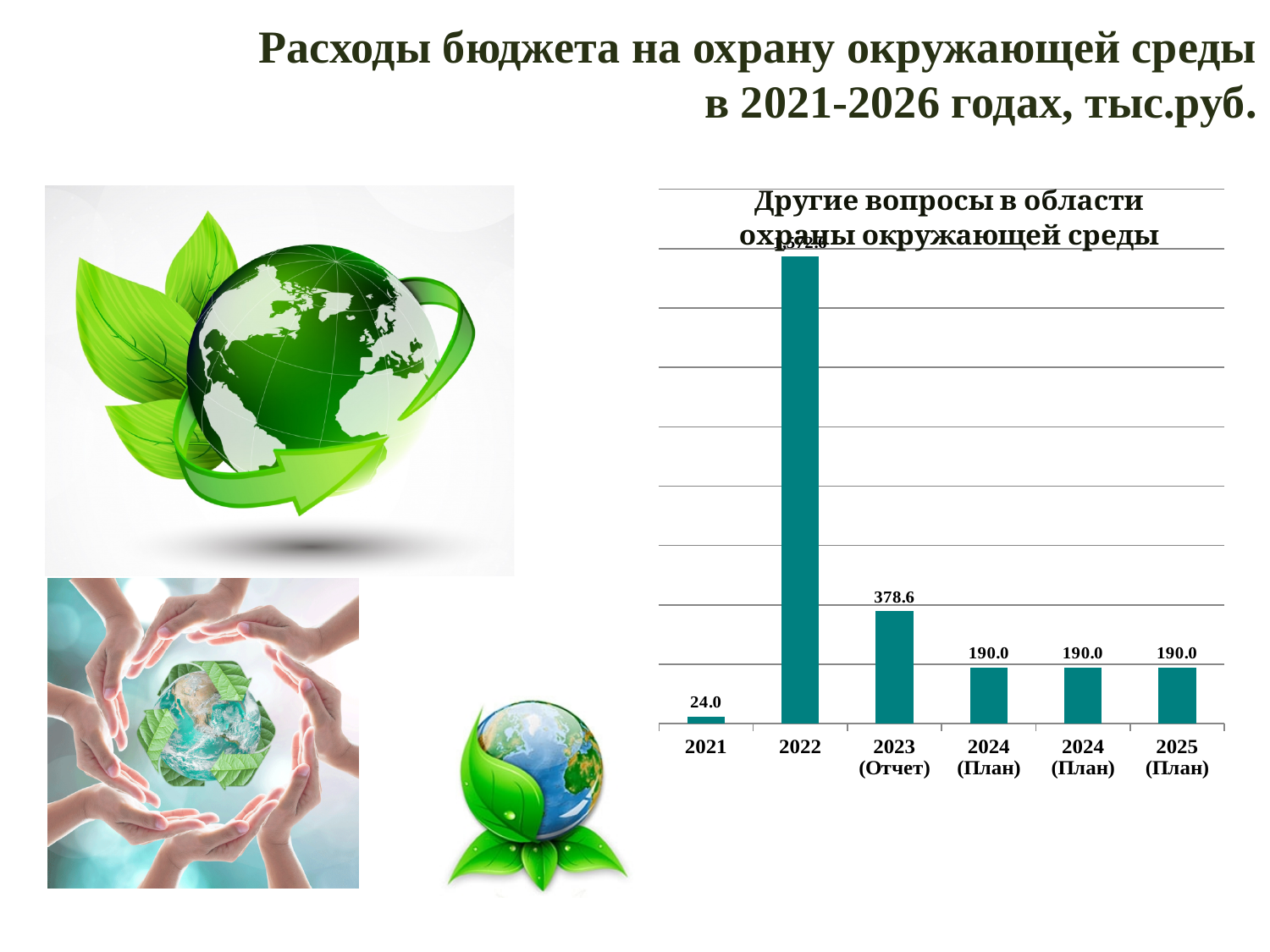
What is the title of the chart? Другие вопросы в области охраны окружающей среды What is the difference between the values for 2023 (Отчет) and 2025 (План)? 188.6 How many bars are shown in the chart? 6 What is the value for 2025 (План)? 190.0 Which year has the highest value? 2022 Do the values rise or fall from 2022 to 2023 (Отчет)? fall Which year has the lowest value? 2021 What type of chart is shown on the slide? bar chart What is the value for 2021? 24.0 Which is larger, the value for 2021 or the value for 2025 (План)? 2025 (План) What is the value for 2023 (Отчет)? 378.6 What is the difference between the values for 2023 (Отчет) and 2021? 354.6